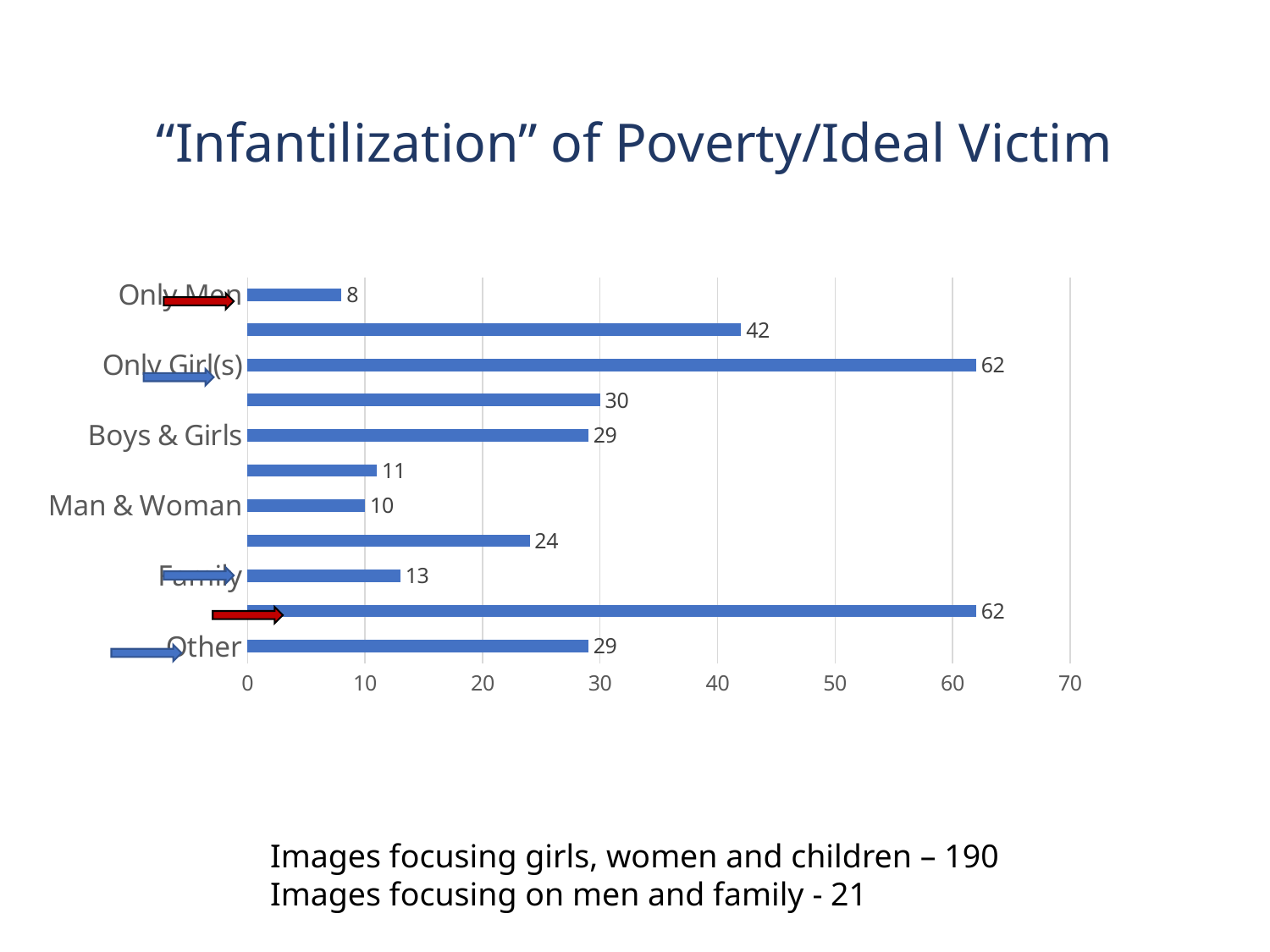
Which category has the lowest value? Only Men What is the value for Other? 29 What is the difference between the values for Only Girl(s) and Only Men? 54 What is the value for Boys & Girls? 29 What is the value for Only Girl(s)? 62 Which is larger, the value for Family or the value for Man & Woman? Family How many bars are plotted in the chart? 11 What kind of chart is shown on the slide? Bar chart What is the value for Only Men? 8 What is the value for Man & Woman? 10 What is the title of the slide containing the chart? “Infantilization” of Poverty/Ideal Victim What is the value for Family? 13